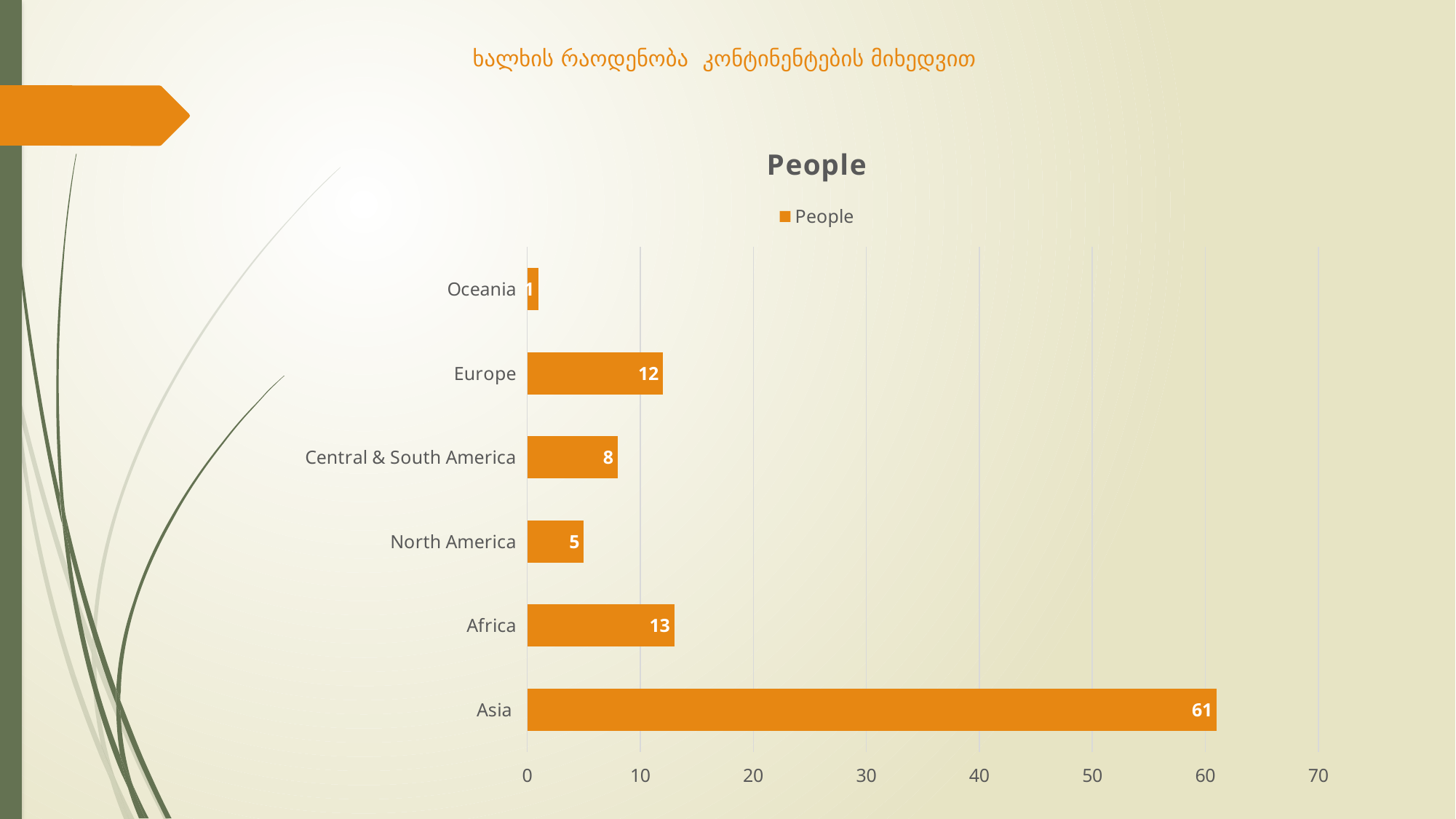
What is the value for Asia? 61 How many categories are shown in the chart? 6 What is the value for Europe? 12 Which category has the highest value? Asia Which category has the lowest value? Oceania What is the difference between the values for Asia and Africa? 48 What is the title of the chart? People What is the value for Africa? 13 What is the value for Central & South America? 8 What kind of chart is shown on the slide? Bar chart Which is larger, the value for Europe or the value for Central & South America? Europe What is the value for North America? 5